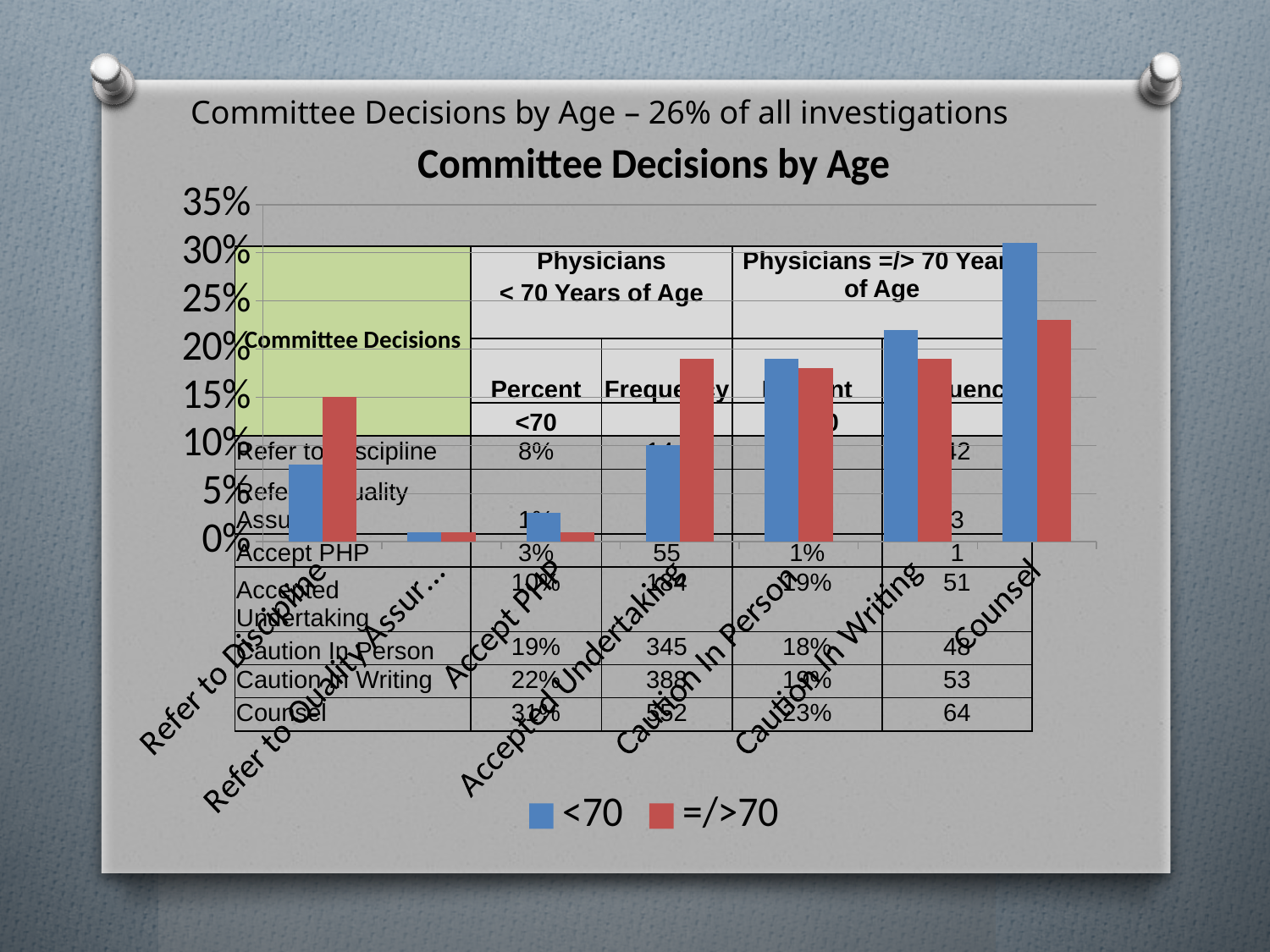
For Accepted Undertaking, which series has the larger value, <70 or =/>70? =/>70 Which category has the highest value for the =/>70 series? Counsel Is the value for Refer to Discipline in the =/>70 series greater or less than 10%? greater Is the value for Counsel in the <70 series greater or less than 25%? greater How many series does the chart legend list? 2 How many categories are shown along the x axis of the chart? 7 What is the title of the chart? Committee Decisions by Age Which category has the lowest value for the <70 series? Refer to Quality Assur... What kind of chart is shown on the slide? bar chart Which category has the highest value for the <70 series? Counsel For Counsel, which series has the larger value, <70 or =/>70? <70 Is the value for Refer to Discipline in the <70 series greater or less than 10%? less